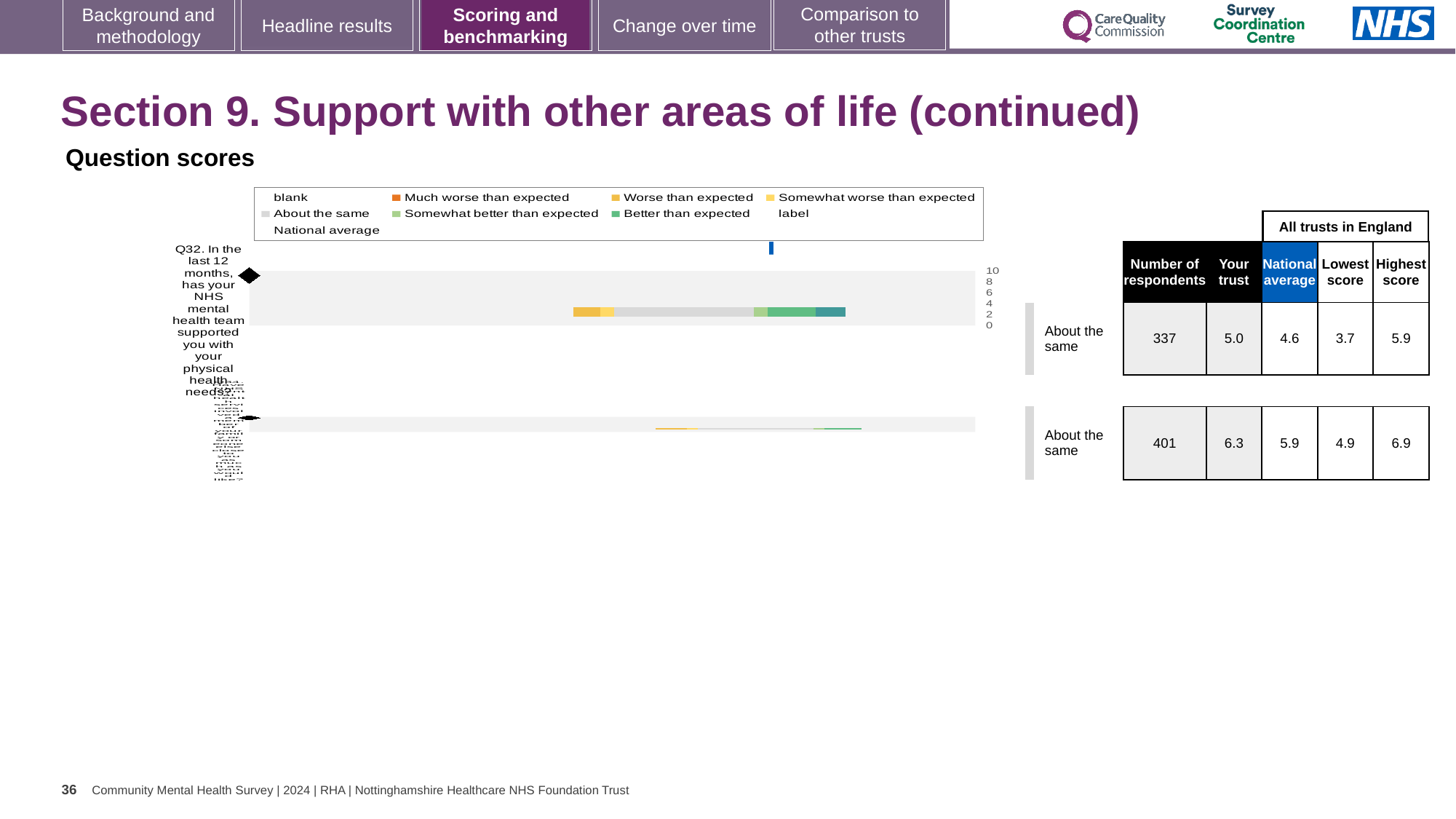
What is the highest score among all trusts in England for Q32? 5.9 How many respondents answered Q32? 337 What is the difference between the trust's score and the national average for Q32? 0.4 What is the lowest score among all trusts in England for Q32? 3.7 What is the 'Your trust' score for Q32 (support with physical health needs)? 5.0 For Q32, which is larger: the trust's score or the national average? Your trust What is the national average score for Q32? 4.6 Which legend entry is shown in orange? Much worse than expected How many question rows are plotted in the chart? 2 What is the difference between the highest and lowest trust scores in England for Q32? 2.2 What kind of chart is used to show the question scores on this slide? bar chart How is the trust's result for Q32 categorised relative to expectations? About the same